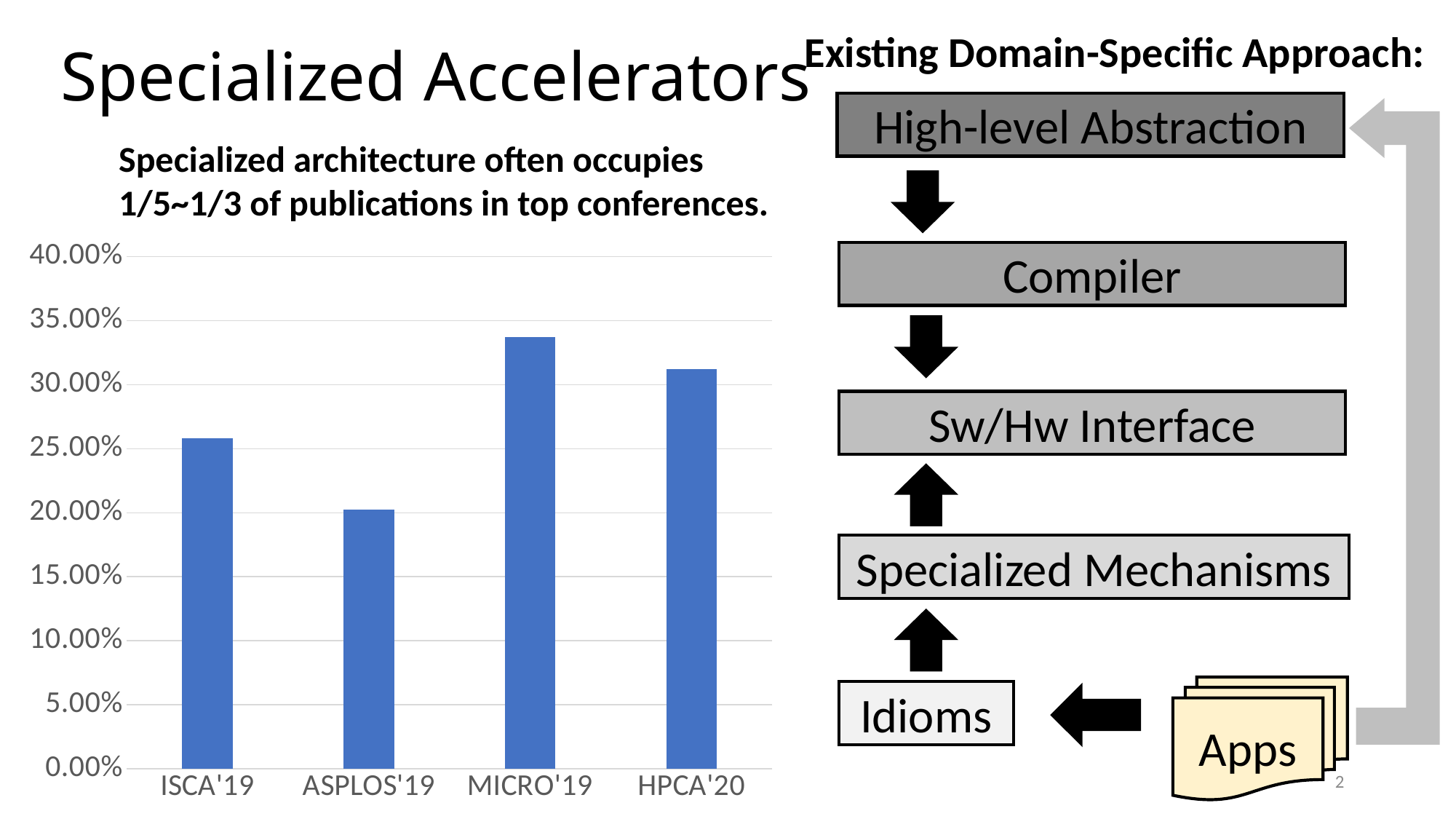
Which is larger, the value for ISCA'19 or the value for ASPLOS'19? ISCA'19 How many conferences are shown on the x axis of the bar chart? 4 Which conference has the lowest bar in the chart? ASPLOS'19 What colour are the bars in the chart? blue What kind of chart is shown on the left of the slide? bar chart Which conference has the highest bar in the chart? MICRO'19 Which is larger, the value for HPCA'20 or the value for ISCA'19? HPCA'20 What is the highest value shown on the y axis of the bar chart? 40.00% Is the value for MICRO'19 greater or less than 35.00%? less Is the value for ASPLOS'19 greater or less than 25.00%? less Is the value for ISCA'19 greater or less than 25.00%? greater